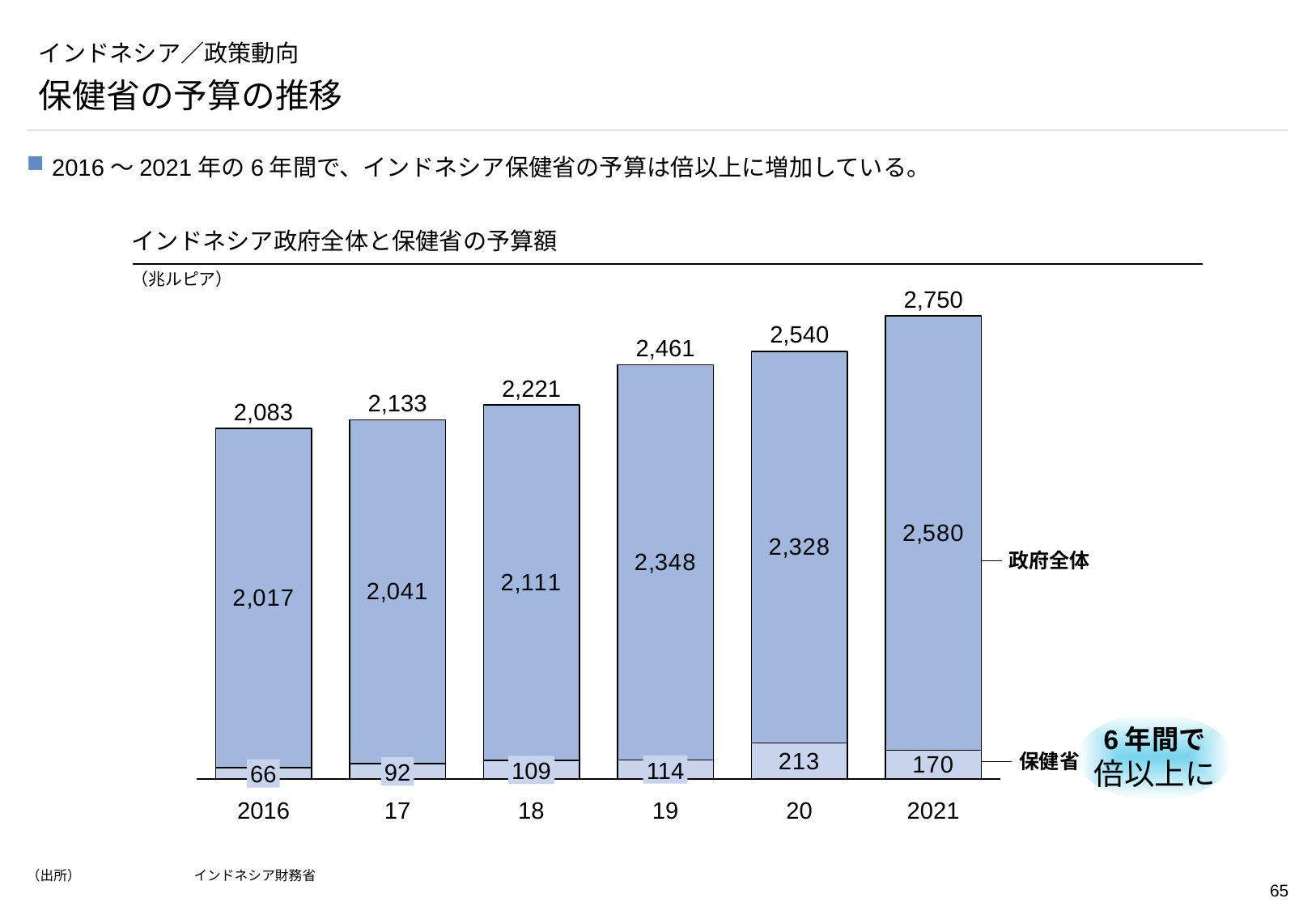
How many years are shown on the x axis? 6 What kind of chart is shown on the slide? Stacked bar chart Which year has the lowest stacked bar total? 2016 What is the total of the stacked bar for 2019? 2,461 What is the 保健省 value for 2016? 66 What is the 政府全体 value for 2021? 2,580 What is the difference between the stacked bar totals for 2021 and 2016? 667 How many series does the chart show? 2 Which year has the highest 保健省 value? 20 Do the stacked bar totals rise or fall from 2016 to 2021? Rise What is the difference between the 保健省 values for 20 and 2021? 43 Which is larger, the 政府全体 value for 19 or for 20? 19